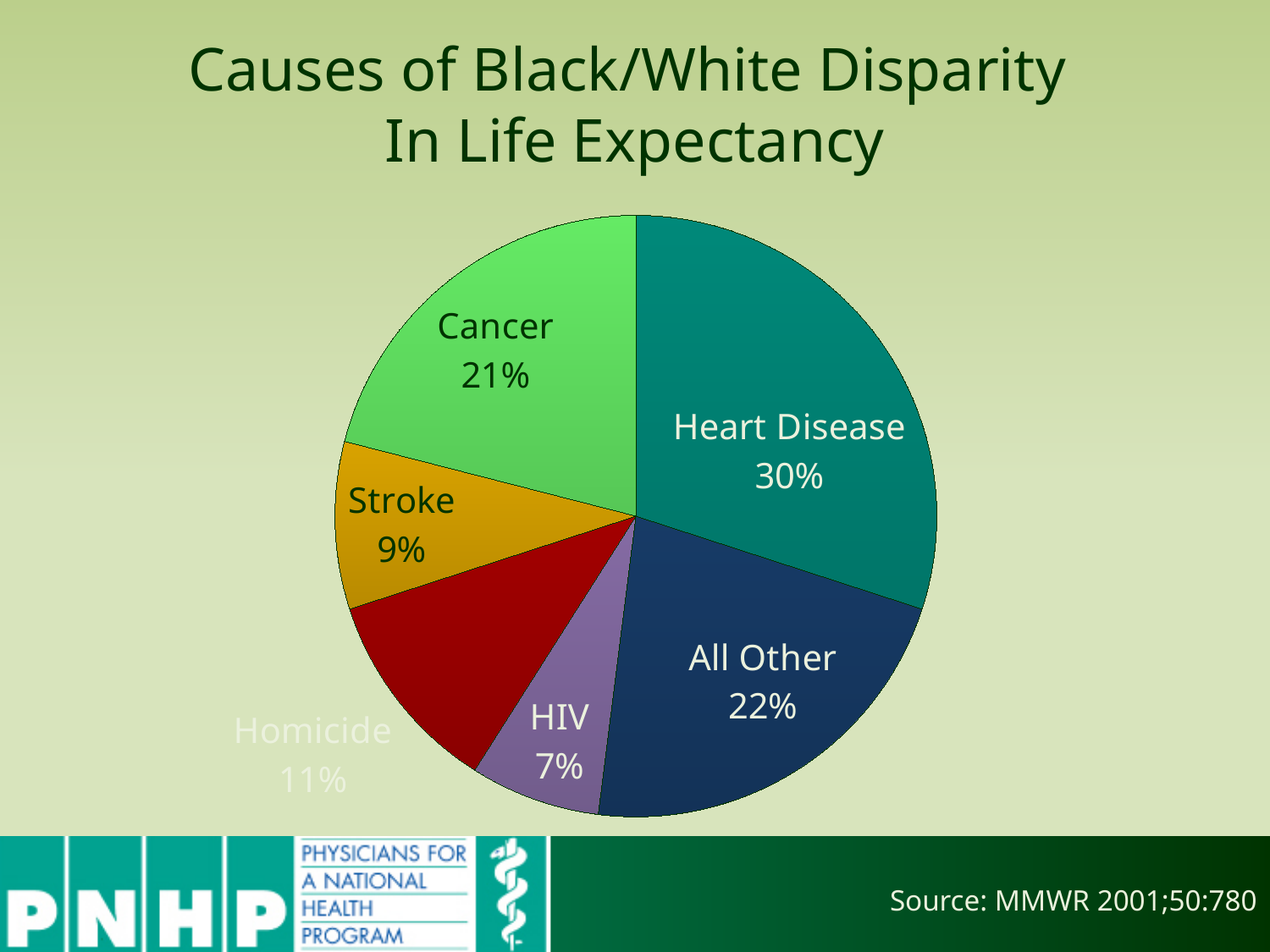
What is the title of the chart on the slide? Causes of Black/White Disparity In Life Expectancy What kind of chart is shown on the slide? pie chart What share of the Black/White disparity in life expectancy is attributed to Heart Disease? 30% What percentage is shown for Stroke? 9% How many slices does the pie chart have? 6 What is the difference in percentage points between Heart Disease and Cancer? 9 What percentage is shown for Cancer? 21% What percentage is shown for HIV? 7% Which is larger, the share for All Other or the share for Cancer? All Other Which cause accounts for the smallest slice of the pie? HIV What percentage is shown for All Other? 22% Which cause accounts for the largest slice of the pie? Heart Disease